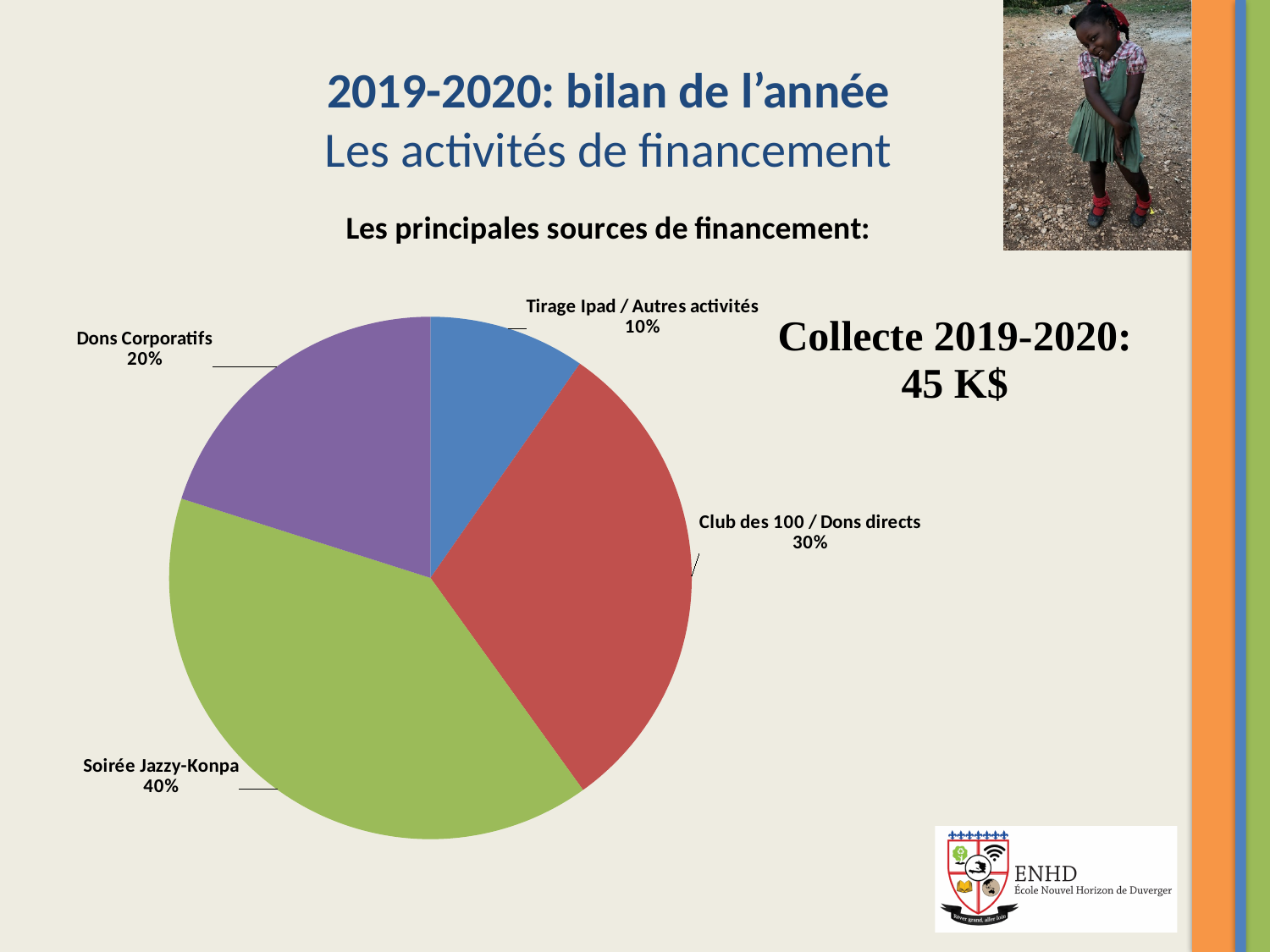
How many slices does the pie chart have? 4 What kind of chart is shown on the slide? pie chart Which funding source has the smallest share of the pie? Tirage Ipad / Autres activités What total amount was collected in 2019-2020 according to the text next to the chart? 45 K$ What share of funding comes from Club des 100 / Dons directs? 30% What share of funding comes from Tirage Ipad / Autres activités? 10% What is the difference in percentage points between Soirée Jazzy-Konpa and Dons Corporatifs? 20 What share of funding comes from Soirée Jazzy-Konpa? 40% Which is larger: the share for Club des 100 / Dons directs or the share for Dons Corporatifs? Club des 100 / Dons directs What colour is the Soirée Jazzy-Konpa slice? green Which funding source has the largest share of the pie? Soirée Jazzy-Konpa What share of funding comes from Dons Corporatifs? 20%